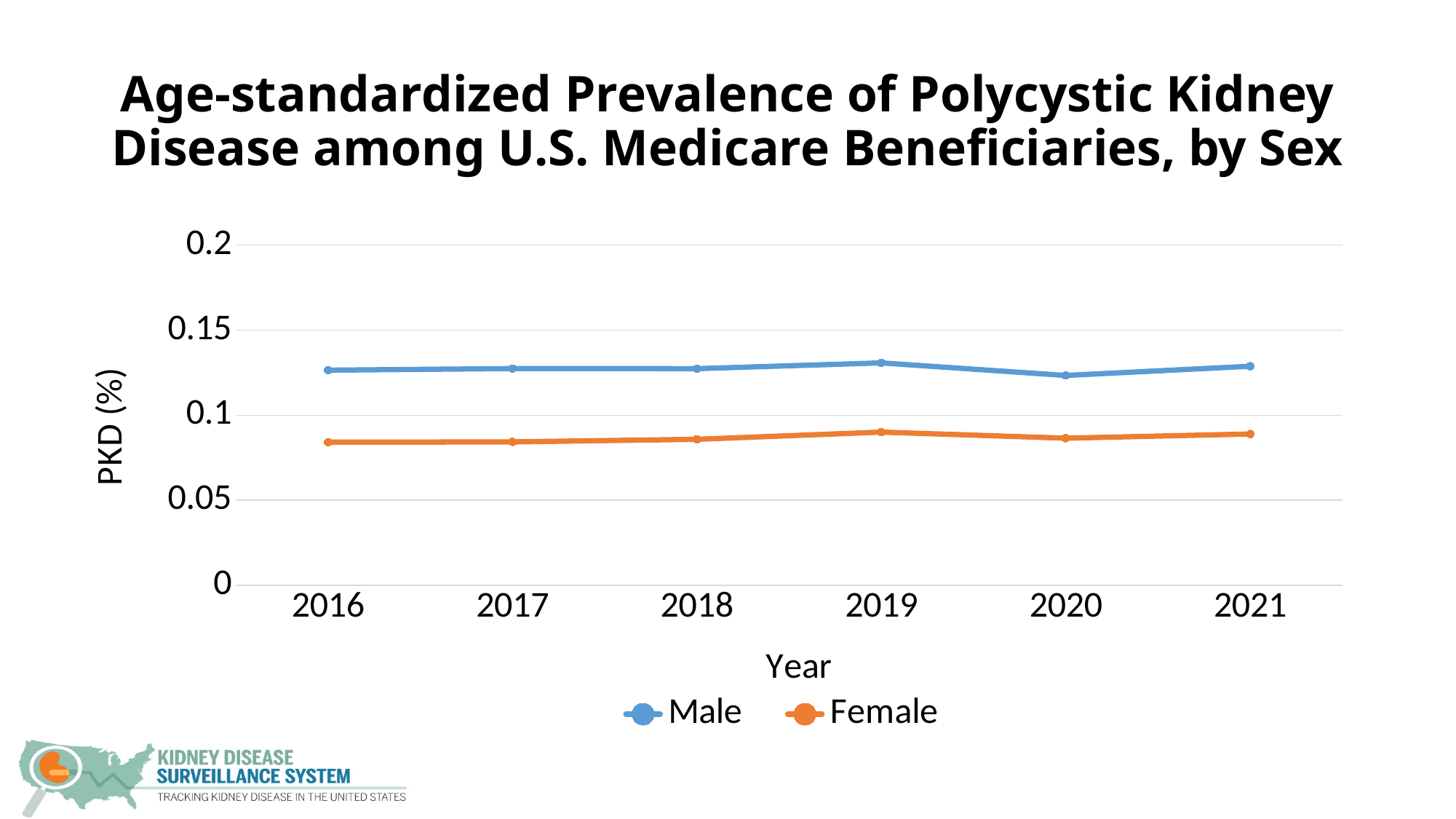
What is the label on the y axis? PKD (%) In which year is the Male series at its lowest? 2020 Which series is drawn in orange? Female Is the value for Female in 2019 greater or less than 0.1? less How many series does the legend list? 2 In which year is the Male series at its highest? 2019 In 2018, which series has the larger value, Male or Female? Male How many years are plotted along the x axis? 6 Is the value for Male in 2019 greater or less than 0.1? greater What kind of chart is shown on the slide? line chart Is the value for Female in 2016 greater or less than 0.05? greater